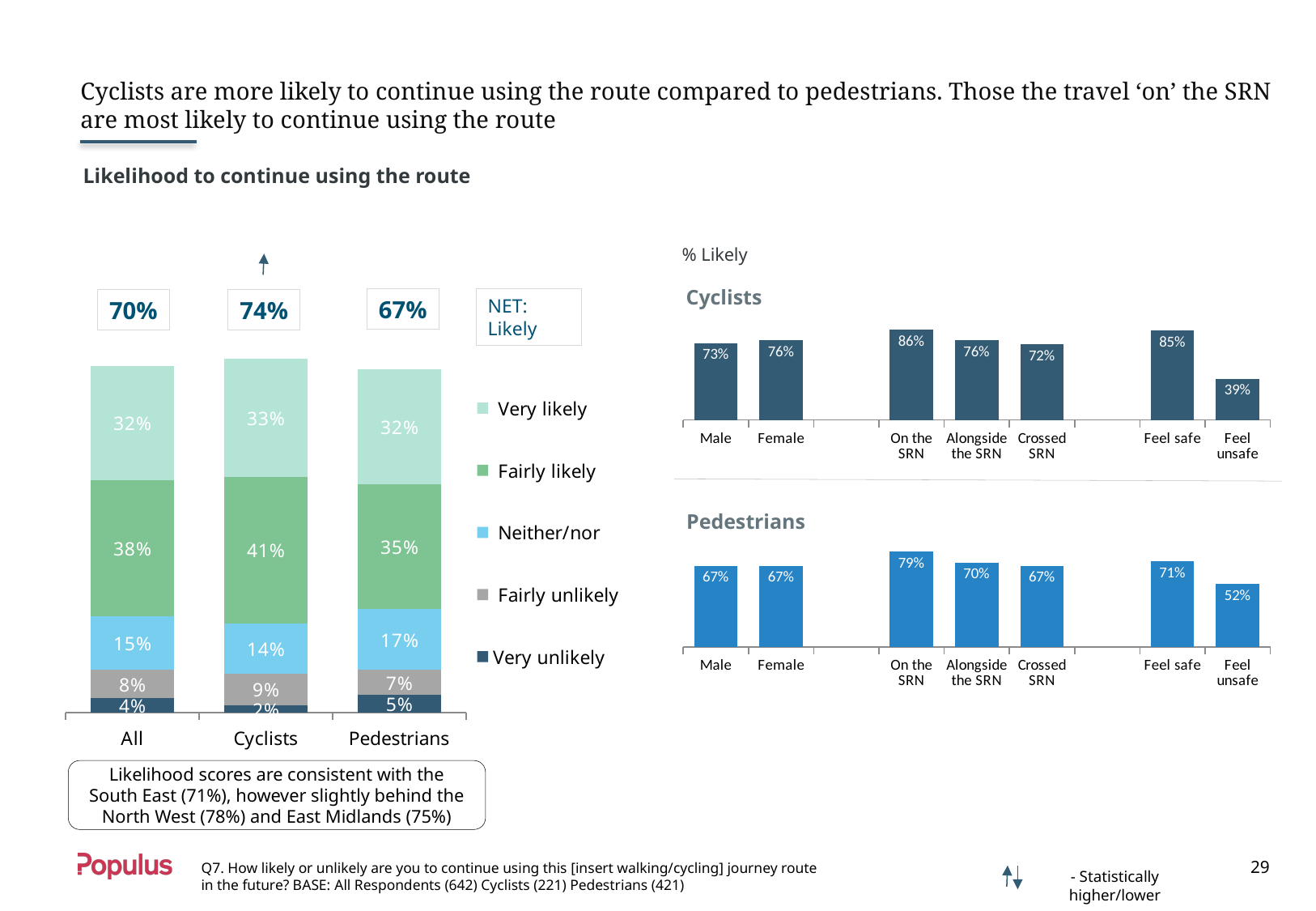
In the 'Cyclists' % Likely chart, what is the value for 'On the SRN'? 86% In the stacked bar chart 'Likelihood to continue using the route', what percentage of Cyclists are 'Fairly likely'? 41% In the 'Cyclists' % Likely chart, which category has the lowest value? Feel unsafe In the 'Pedestrians' % Likely chart, how many categories are shown? 7 In the 'Cyclists' % Likely chart, what is the difference between 'Feel safe' and 'Feel unsafe'? 46% In the stacked bar chart 'Likelihood to continue using the route', what is the 'Neither/nor' value for Pedestrians? 17% Which is larger: the 'Feel unsafe' value in the 'Cyclists' chart or the 'Feel unsafe' value in the 'Pedestrians' chart? Pedestrians (52%) In the stacked bar chart 'Likelihood to continue using the route', which group has the lowest NET: Likely figure? Pedestrians In the stacked bar chart 'Likelihood to continue using the route', how many series does the legend list? 5 In the stacked bar chart 'Likelihood to continue using the route', what is the difference between the 'Very unlikely' values for Pedestrians and Cyclists? 3% In the stacked bar chart 'Likelihood to continue using the route', what is the NET: Likely figure for Cyclists? 74% In the 'Pedestrians' % Likely chart, which category has the highest value? On the SRN